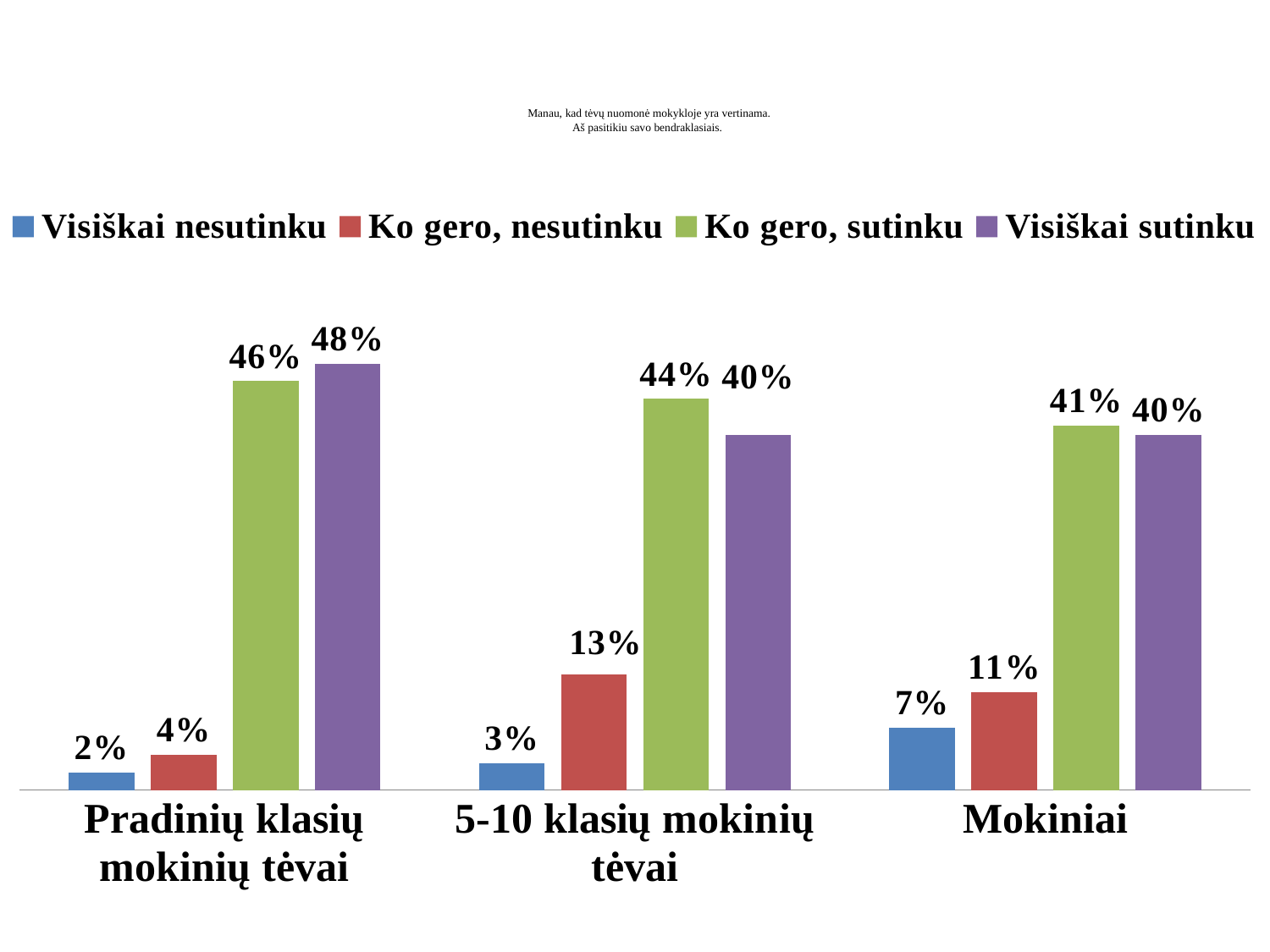
What kind of chart is shown on the slide? Bar chart What is the value for "Visiškai sutinku" in the "Pradinių klasių mokinių tėvai" category? 48% Which category has the lowest value for "Visiškai nesutinku"? Pradinių klasių mokinių tėvai What is the value for "Visiškai nesutinku" in the "Mokiniai" category? 7% Which colour represents the "Ko gero, sutinku" series? Green Which is larger in the "Mokiniai" category: "Ko gero, nesutinku" or "Visiškai nesutinku"? Ko gero, nesutinku What is the value for "Ko gero, sutinku" in the "Mokiniai" category? 41% What is the difference between "Ko gero, sutinku" and "Ko gero, nesutinku" in the "5-10 klasių mokinių tėvai" category? 31% How many series does the legend list? 4 How many categories are shown on the x axis? 3 What is the value for "Ko gero, nesutinku" in the "5-10 klasių mokinių tėvai" category? 13% Which category has the highest value for "Visiškai sutinku"? Pradinių klasių mokinių tėvai